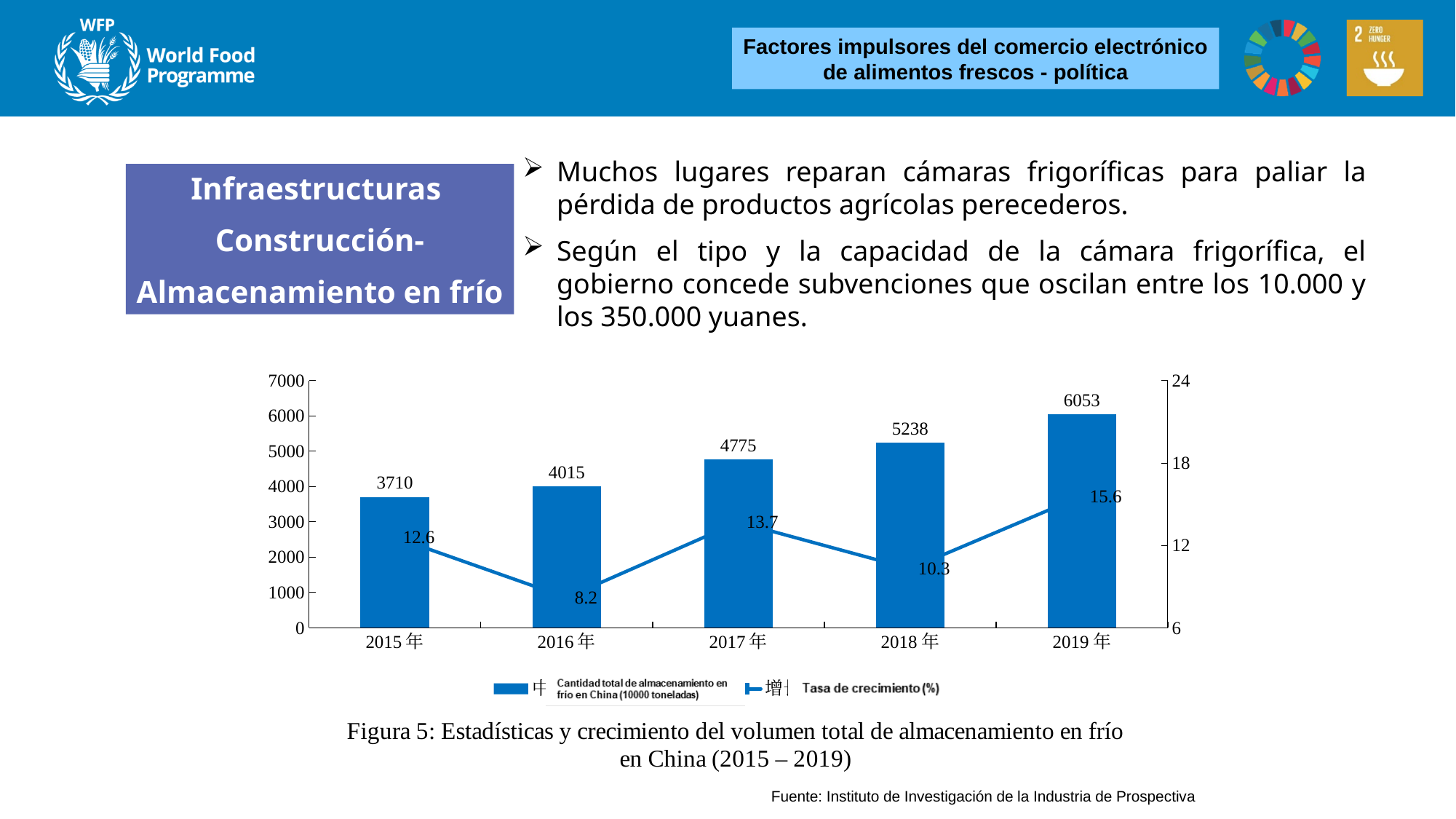
Do the bar values for total cold storage quantity rise or fall from 2015 年 to 2019 年? rise What is the growth rate (Tasa de crecimiento) shown for 2016 年? 8.2 What is the total cold storage quantity in China for 2017 年? 4775 What is the growth rate shown for 2019 年? 15.6 Which year has the highest total cold storage quantity? 2019 年 How many series does the chart legend list? 2 What is the difference between the cold storage quantity in 2019 年 and 2018 年? 815 Which is larger, the growth rate in 2017 年 or in 2018 年? 2017 年 Is the cold storage quantity for 2016 年 greater or less than 5000? less Which year has the lowest growth rate? 2016 年 How many years are shown on the x axis of the chart? 5 What is the figure caption of the chart? Figura 5: Estadísticas y crecimiento del volumen total de almacenamiento en frío en China (2015 – 2019)